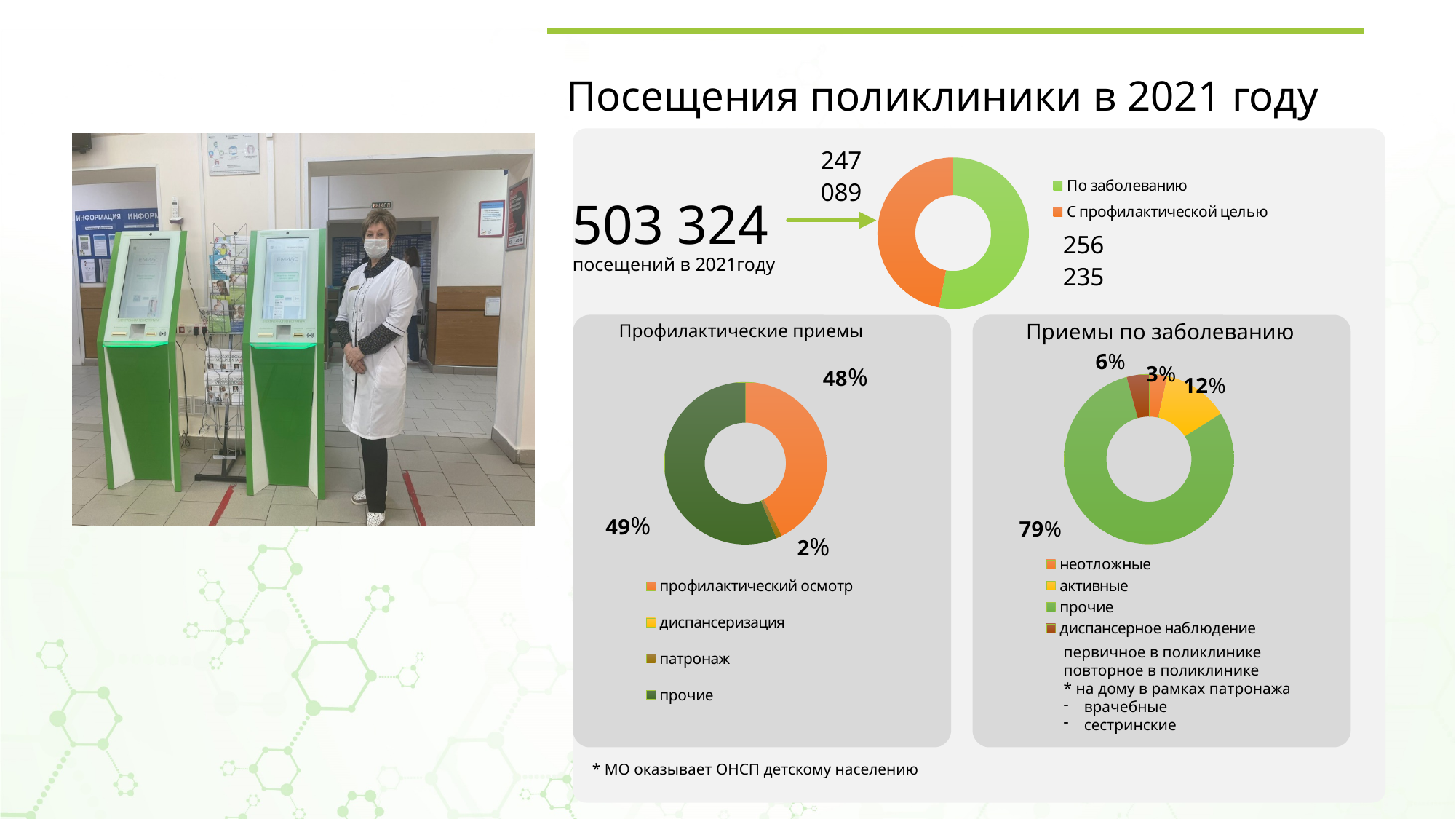
What type of chart is used for 'Приемы по заболеванию'? Donut (pie) chart In the top donut chart, what is the value for 'С профилактической целью'? 247 089 What is the total number of visits in 2021 shown next to the top donut chart? 503 324 In the 'Профилактические приемы' chart, what share is labelled for 'патронаж'? 2% In the 'Приемы по заболеванию' chart, what share is labelled for 'прочие'? 79% In the 'Профилактические приемы' chart, what share is labelled for 'прочие'? 49% In the top donut chart, which category is larger: 'По заболеванию' or 'С профилактической целью'? По заболеванию How many entries does the legend of the 'Профилактические приемы' chart list? 4 In the 'Приемы по заболеванию' chart, which category has the smallest share? неотложные In the top donut chart, what is the value for 'По заболеванию'? 256 235